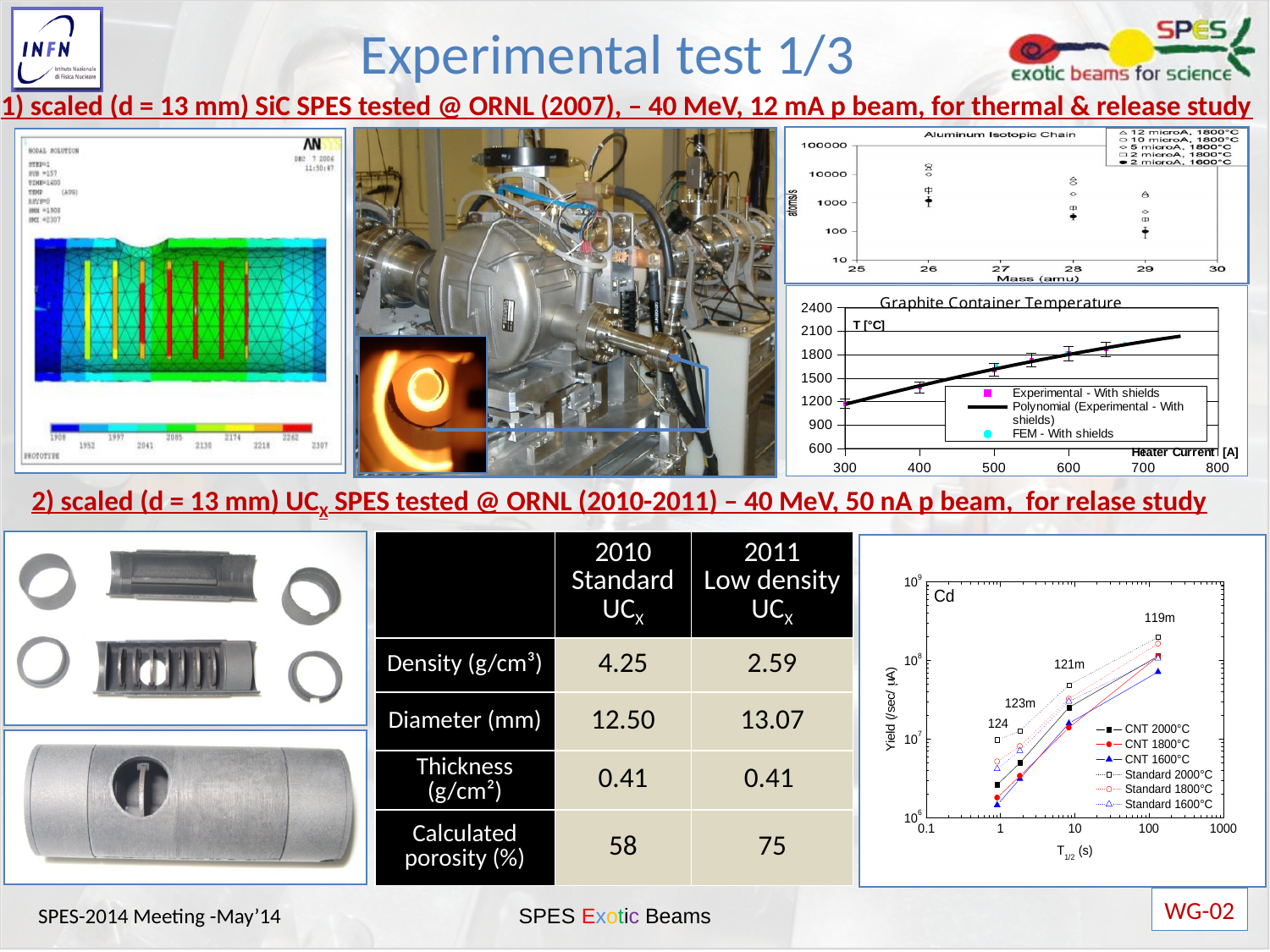
What kind of chart is the Aluminum Isotopic Chain chart? scatter chart On the Aluminum Isotopic Chain chart, at how many mass values (amu) are data points plotted? 3 On the Cd yield chart (bottom right), does the yield rise or fall as T1/2 increases? rise On the Graphite Container Temperature chart, is the temperature at a heater current of 650 A greater or less than 1500 °C? greater On the Graphite Container Temperature chart, how many series does the legend list? 3 On the Aluminum Isotopic Chain chart, how many series does the legend list? 5 On the Cd yield chart (bottom right), how many isotopes are labelled on the plot? 4 On the Graphite Container Temperature chart, is the temperature at a heater current of 300 A greater or less than 1500 °C? less On the Cd yield chart (bottom right), how many series does the legend list? 6 On the Graphite Container Temperature chart, does the temperature rise or fall as the heater current increases? rise On the Graphite Container Temperature chart, what quantity is plotted on the x axis? Heater Current [A]